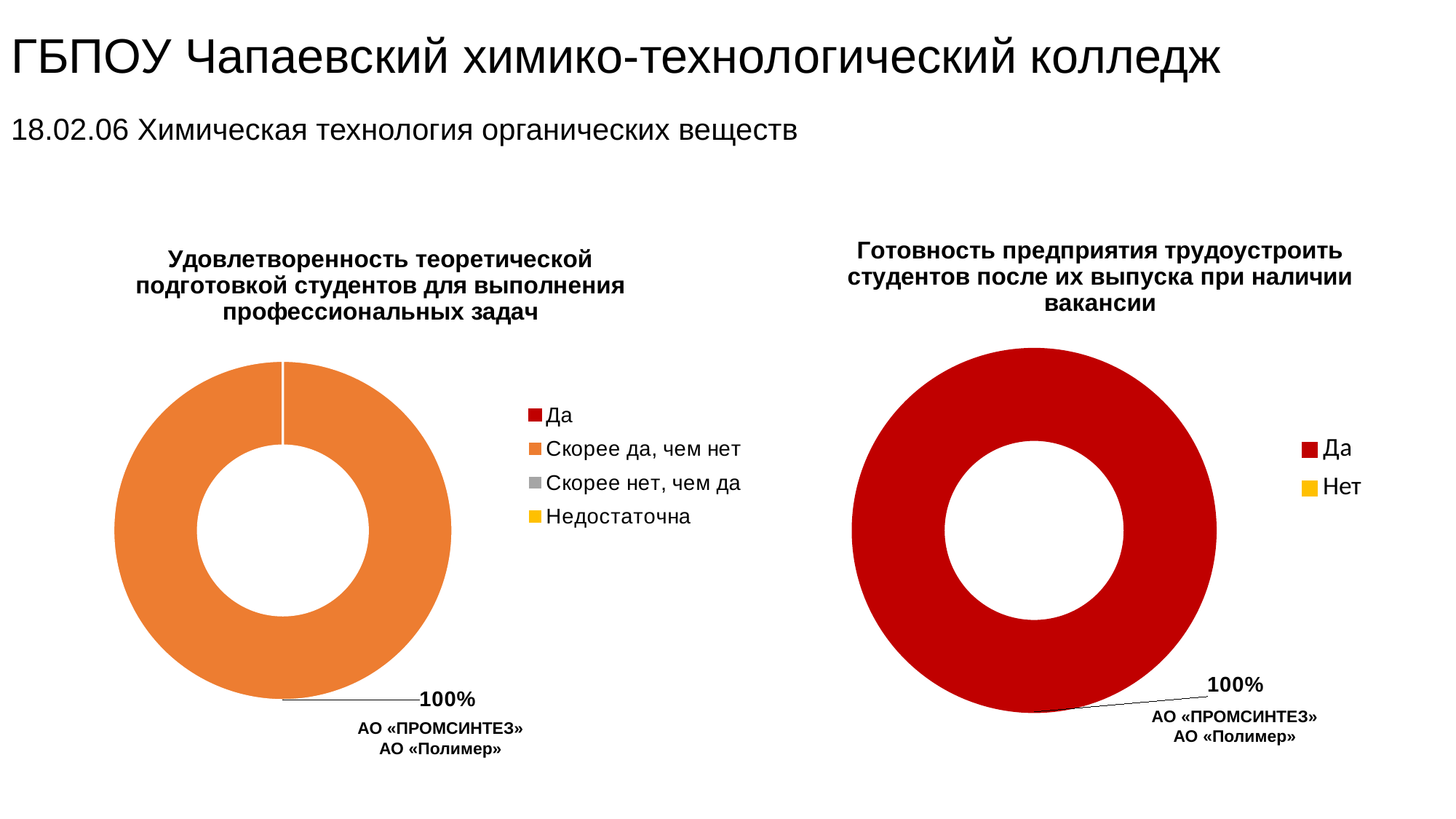
In the right chart, what share of the ring does 'Да' take? 100% Which companies are named in the data label under the right chart? АО «ПРОМСИНТЕЗ», АО «Полимер» What kind of chart is the left chart? doughnut chart What kind of chart is the right chart? doughnut chart In the right chart, what colour is the legend marker for 'Нет'? yellow In the left chart, 'Удовлетворенность теоретической подготовкой студентов для выполнения профессиональных задач', what percentage is shown for 'Скорее да, чем нет'? 100% In the right chart, which legend category accounts for the entire ring? Да In the left chart, what share of the ring does 'Скорее да, чем нет' take? 100% In the right chart, 'Готовность предприятия трудоустроить студентов после их выпуска при наличии вакансии', what percentage is shown for 'Да'? 100% How many entries does the legend of the right chart list? 2 How many entries does the legend of the left chart list? 4 In the left chart, which legend category accounts for the entire ring? Скорее да, чем нет